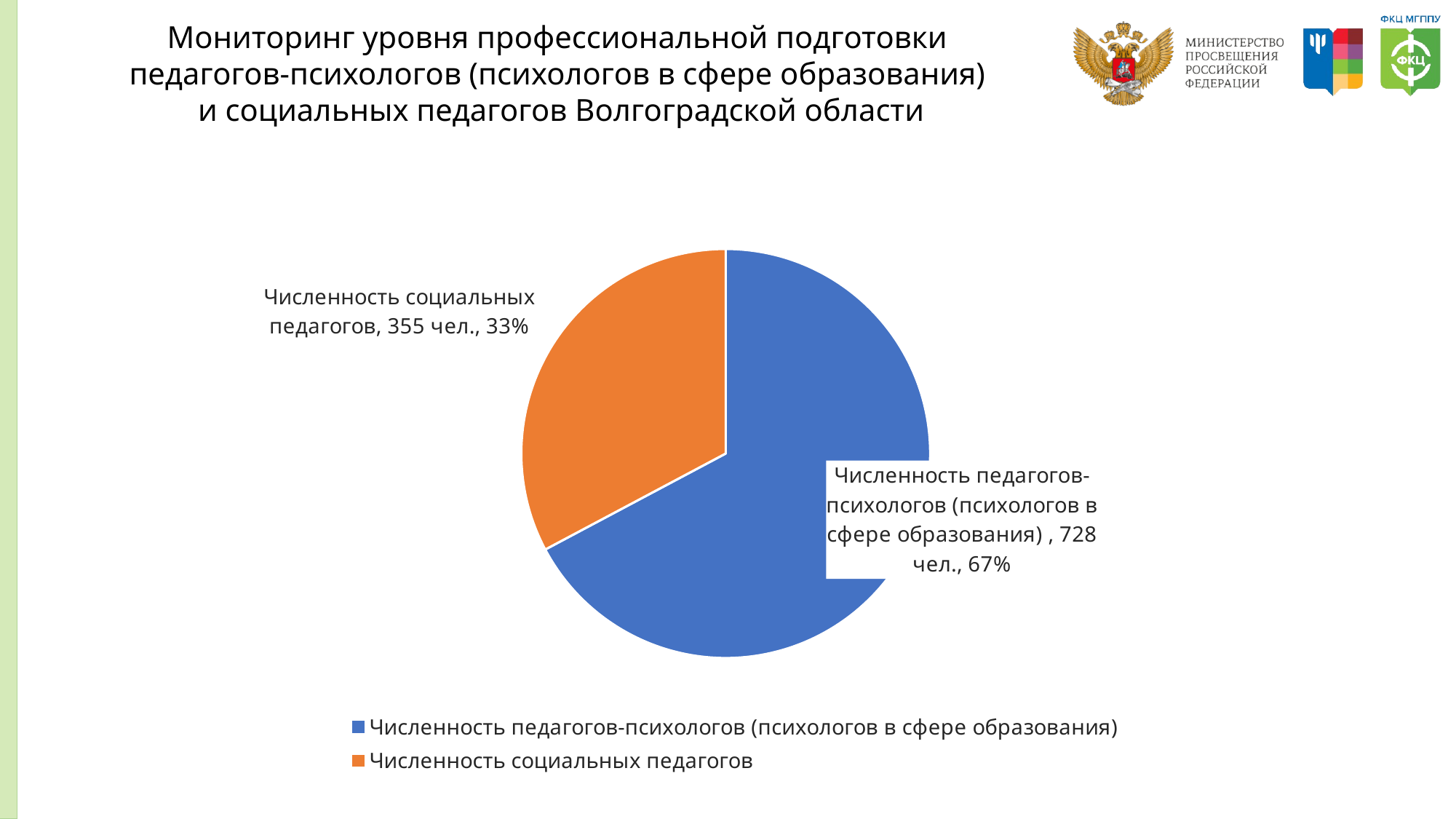
What kind of chart is shown on the slide? Pie chart Which category has the smallest slice of the pie? Численность социальных педагогов What share of the pie does Численность социальных педагогов represent? 33% What is the number of социальные педагоги shown on the pie chart? 355 чел. What share of the pie does Численность педагогов-психологов (психологов в сфере образования) represent? 67% Which category has the largest slice of the pie? Численность педагогов-психологов (психологов в сфере образования) What is the difference in headcount between педагоги-психологи and социальные педагоги? 373 чел. How many entries does the legend list? 2 How many slices does the pie chart have? 2 Which is larger: the number of педагоги-психологи or the number of социальные педагоги? Численность педагогов-психологов (психологов в сфере образования) What colour is the slice for Численность социальных педагогов? Orange What is the number of педагоги-психологи (психологи в сфере образования) shown on the pie chart? 728 чел.